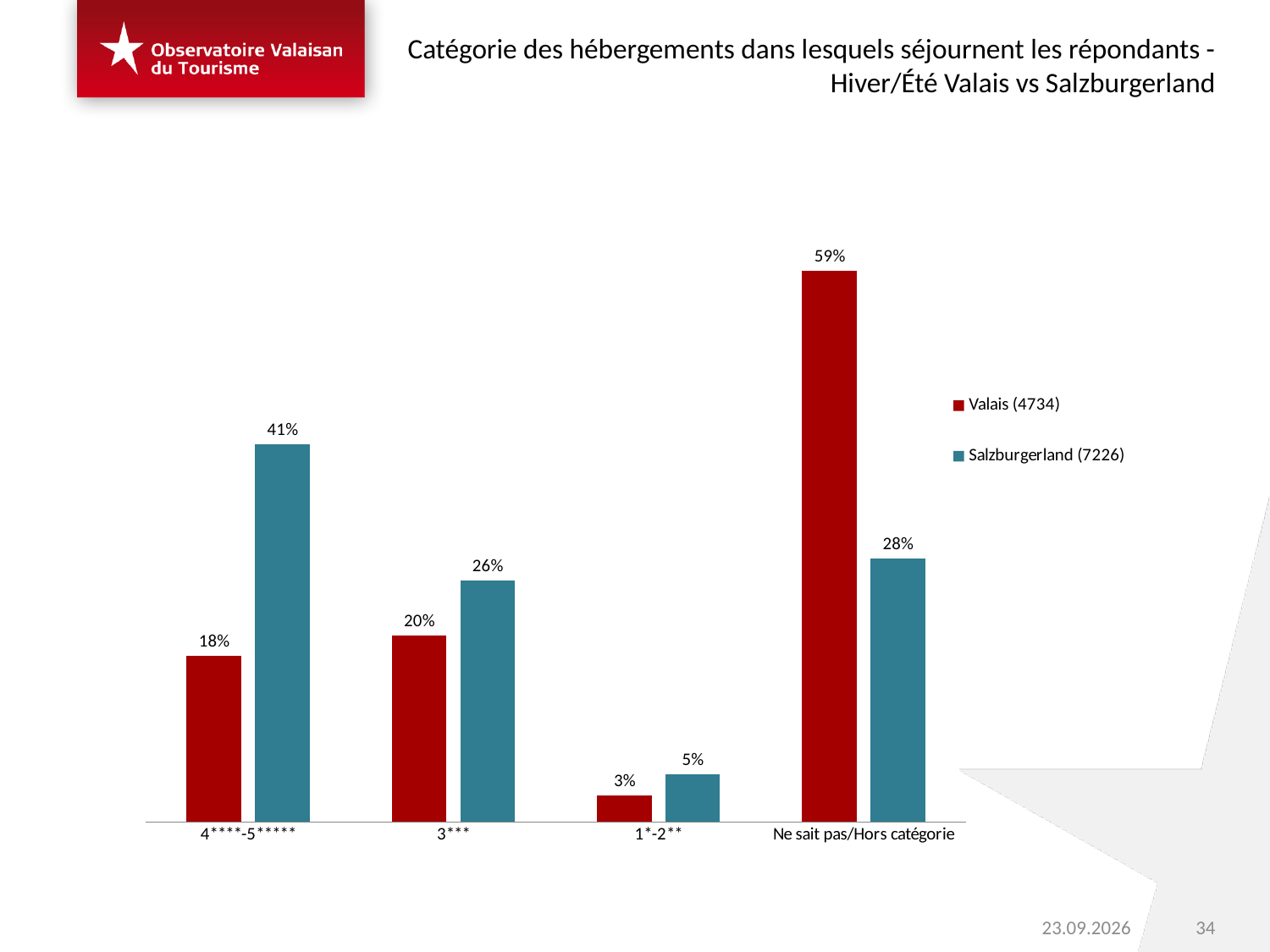
Which is larger in the Ne sait pas/Hors catégorie category, Valais or Salzburgerland? Valais Which category has the lowest value for Valais? 1*-2** What is the value for Salzburgerland in the 1*-2** category? 5% What is the value for Salzburgerland in the 3*** category? 26% What kind of chart is shown on the slide? Bar chart How many series does the legend list? 2 Which category has the highest value for Salzburgerland? 4****-5***** What is the difference between Salzburgerland and Valais in the 4****-5***** category? 23% What is the value for Valais in the Ne sait pas/Hors catégorie category? 59% What is the value for Valais in the 4****-5***** category? 18% What colour are the bars for the Valais series? Red How many categories are shown on the x axis? 4